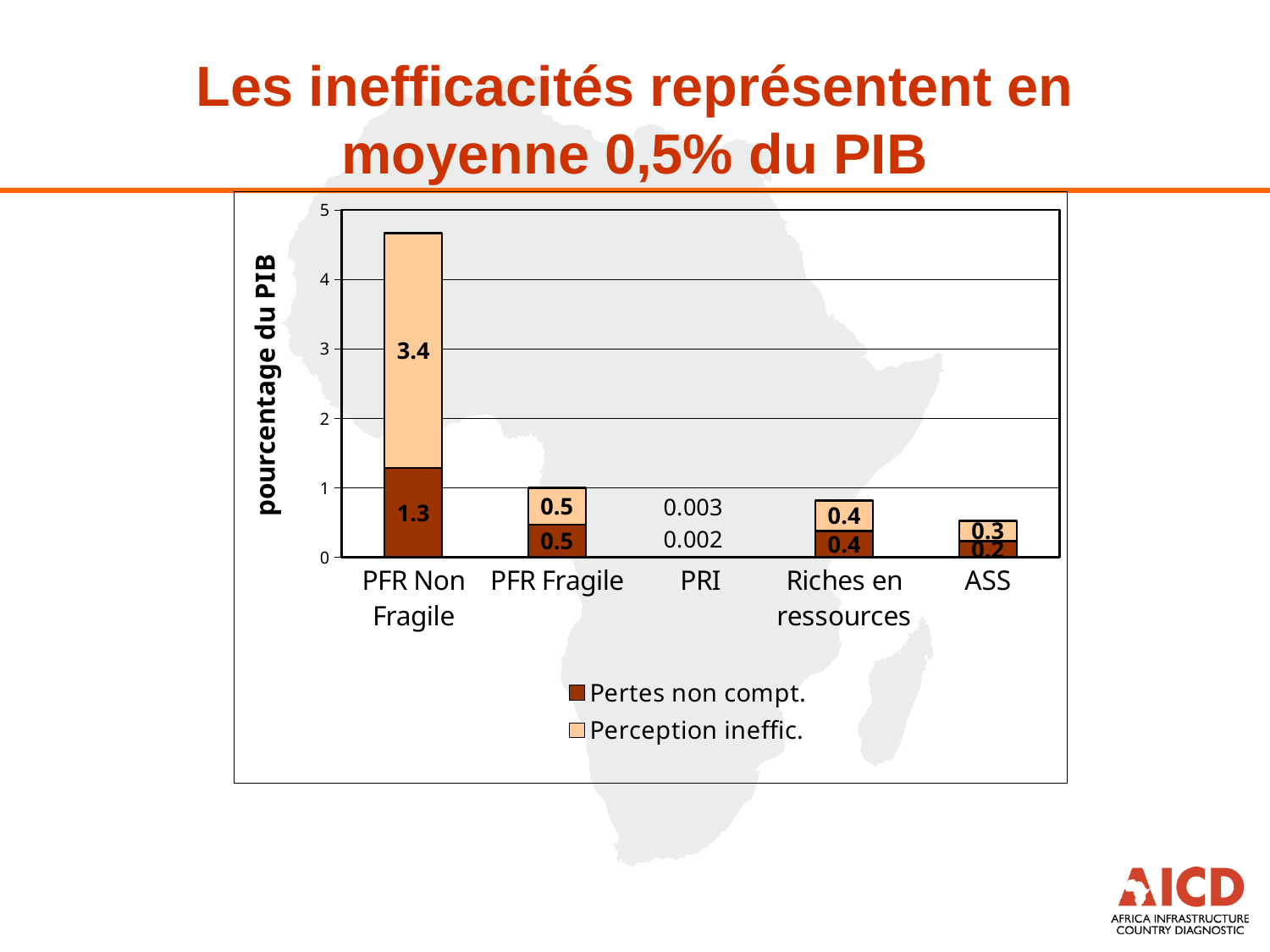
What is the value of Perception ineffic. for PFR Non Fragile? 3.4 How many series does the legend list? 2 What is the value of Perception ineffic. for PRI? 0.003 What is the difference between Perception ineffic. and Pertes non compt. for PFR Non Fragile? 2.1 Which category has the lowest total stacked bar? PRI What type of chart is shown on the slide? stacked bar chart What is the value of Pertes non compt. for PFR Non Fragile? 1.3 Which category has the highest total stacked bar? PFR Non Fragile What is the total of the stacked bar for PFR Non Fragile? 4.7 What is the label of the y axis? pourcentage du PIB What is the value of Pertes non compt. for ASS? 0.2 How many categories are shown on the x axis? 5